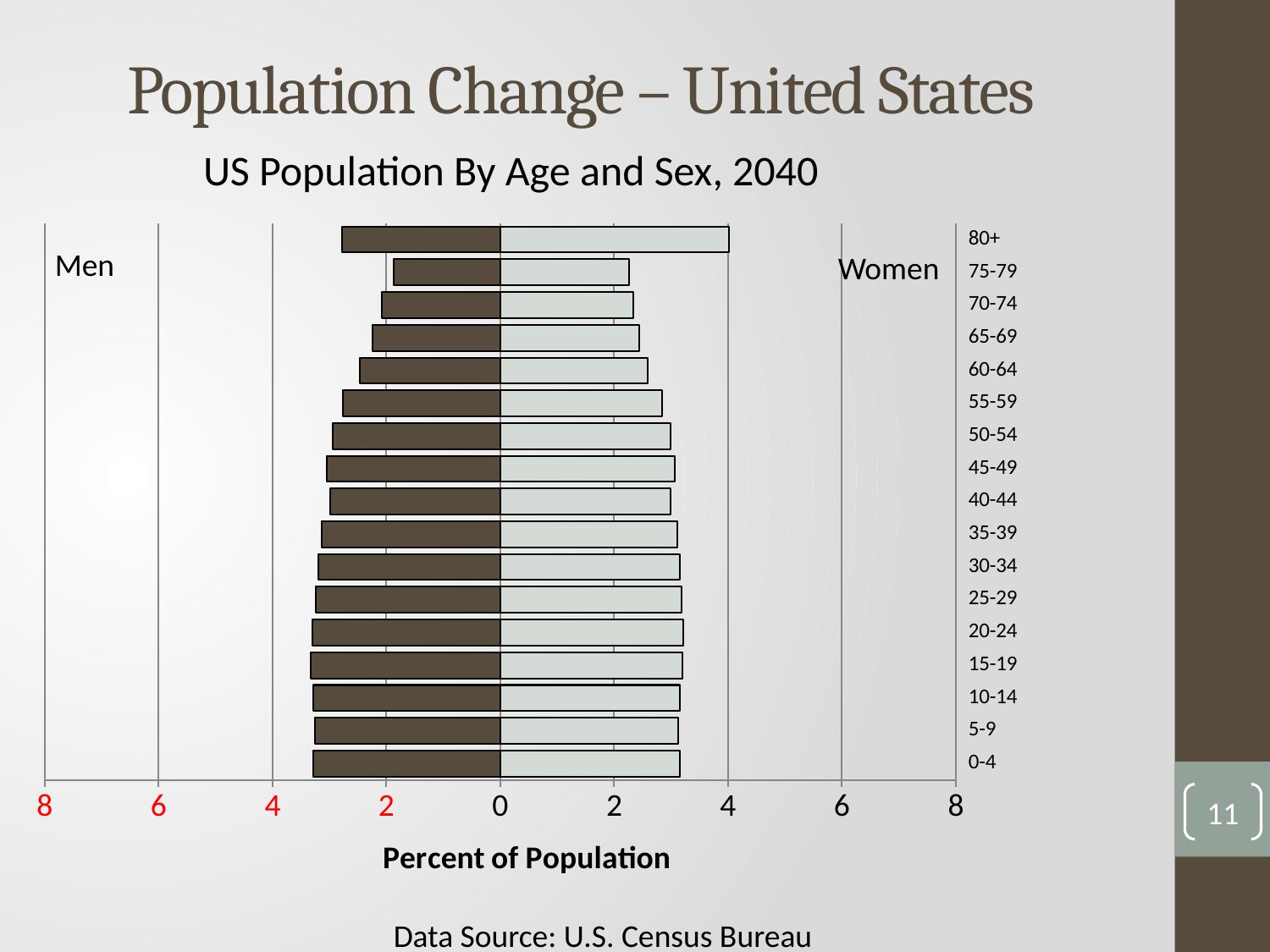
For the 80+ age group, which is larger, the Men value or the Women value? Women What kind of chart is shown on the slide? bar chart Moving from the 0-4 group up to the 75-79 group, do the Men's bars generally get longer or shorter? shorter Is the value for Women aged 0-4 greater or less than 2? greater Is the value for Men aged 80+ greater or less than 2? greater Which age group has the longest bar for Women? 80+ What is the label of the horizontal axis? Percent of Population What is the title of the chart? US Population By Age and Sex, 2040 Is the value for Women aged 80+ greater or less than 2? greater How many age groups are shown on the chart? 17 How many series (sexes) does the chart show? 2